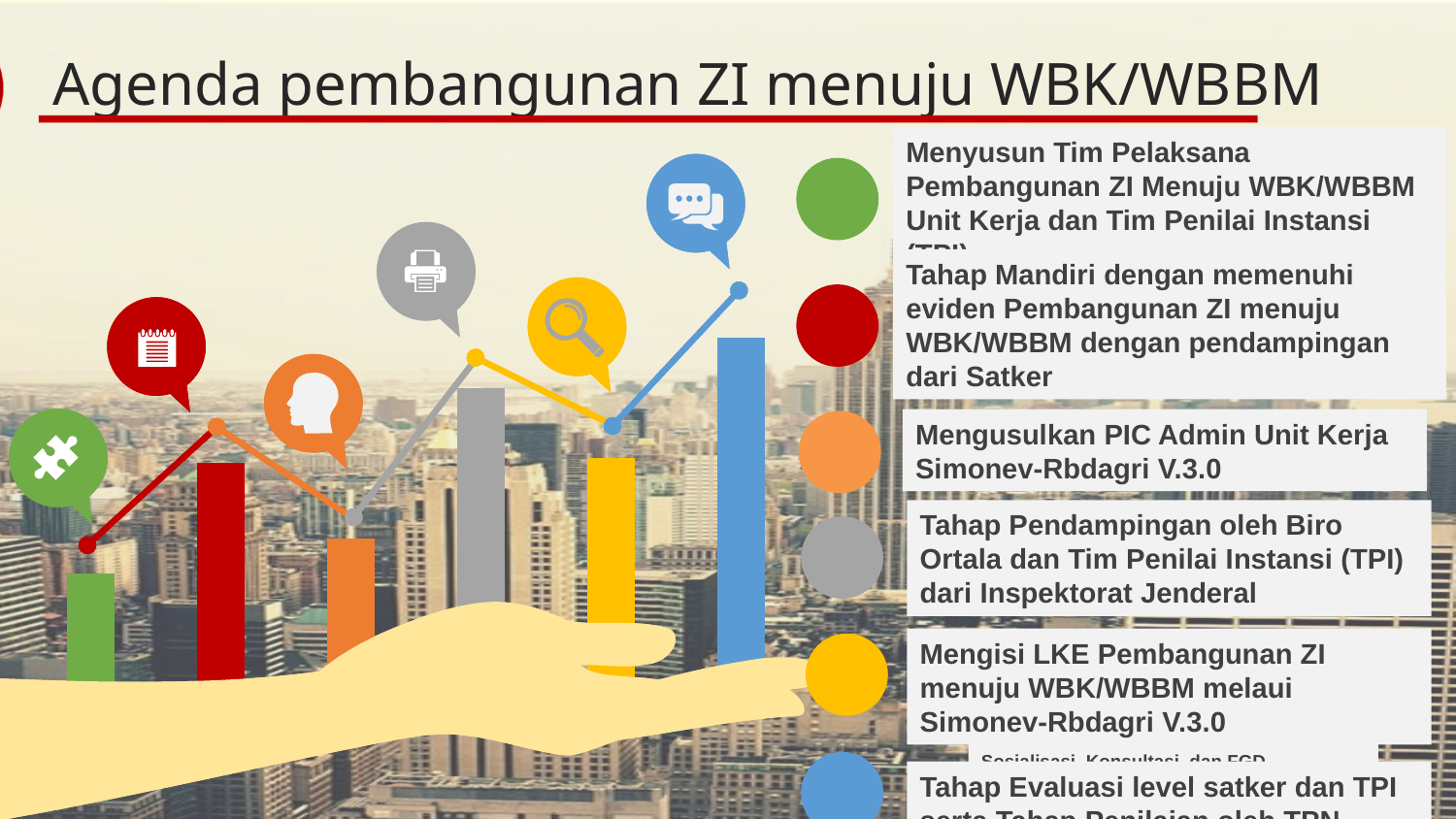
How many bars does the chart on the slide have? 6 Is the gray bar or the orange bar taller? gray Is the red bar or the green bar taller? red Which coloured bar is the tallest in the chart? blue Does the chart show any numeric axis or data labels? no Is the blue bar or the green bar taller? blue Which coloured bar is the shortest in the chart? green What colour is the bar on the far right of the chart? blue What kind of chart is shown on the slide? bar chart with a line